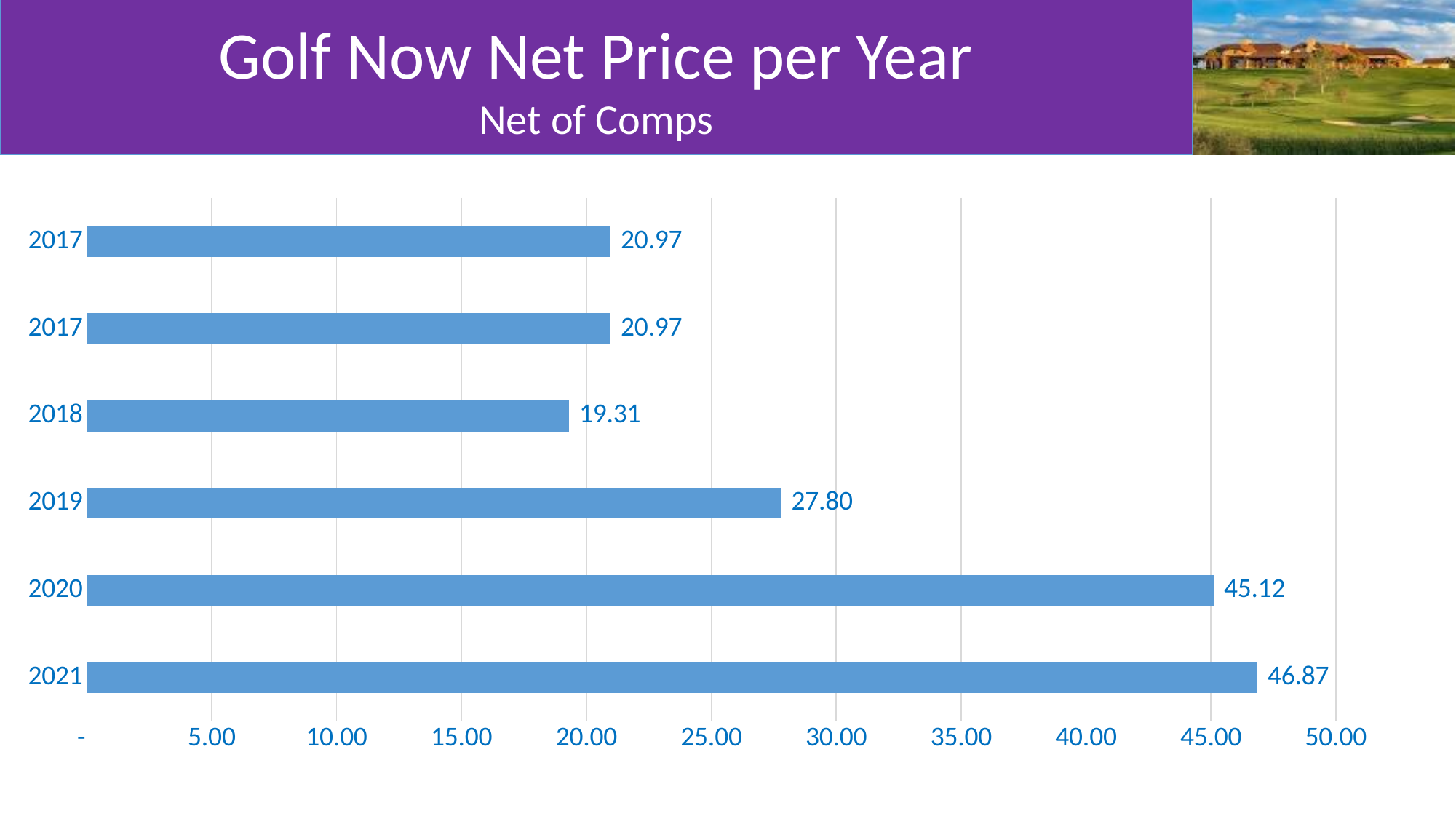
Is the value for 2020 greater or less than 40.00? greater What is the value for 2019? 27.80 What is the difference between the values for 2019 and 2018? 8.49 What is the value for 2021? 46.87 Which is larger, the value for 2019 or the value for 2018? 2019 What is the difference between the values for 2021 and 2020? 1.75 What is the value for 2020? 45.12 Which year has the lowest value? 2018 How many bars are plotted on the chart? 6 What kind of chart is shown on the slide? bar chart What is the value for 2018? 19.31 Which year has the highest value? 2021